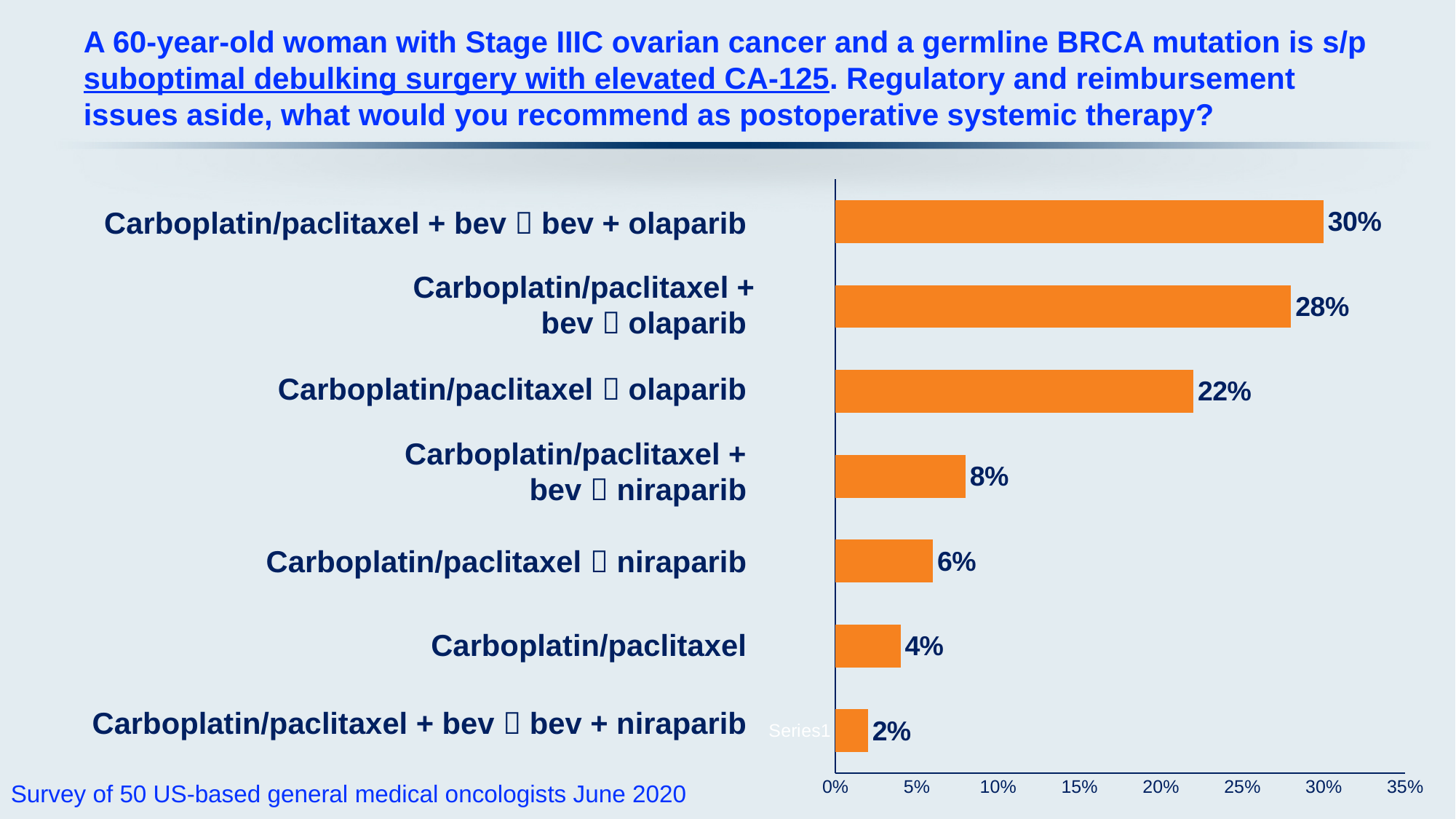
What type of chart is shown on the slide? Bar chart Which option received the lowest percentage of recommendations? Carboplatin/paclitaxel + bev → bev + niraparib Which option received the highest percentage of recommendations? Carboplatin/paclitaxel + bev → bev + olaparib What is the difference in percentage points between carboplatin/paclitaxel + bev → olaparib and carboplatin/paclitaxel → olaparib? 6 percentage points What percentage of respondents recommended carboplatin/paclitaxel + bev → bev + olaparib? 30% Which received a higher percentage: carboplatin/paclitaxel + bev → niraparib or carboplatin/paclitaxel → niraparib? Carboplatin/paclitaxel + bev → niraparib What is the maximum value shown on the horizontal axis? 35% How many oncologists were surveyed according to the slide? 50 What percentage of respondents recommended carboplatin/paclitaxel alone? 4% What percentage of respondents recommended carboplatin/paclitaxel → olaparib? 22% How many treatment options are shown in the chart? 7 Is the value for carboplatin/paclitaxel + bev → olaparib greater or less than 25%? greater